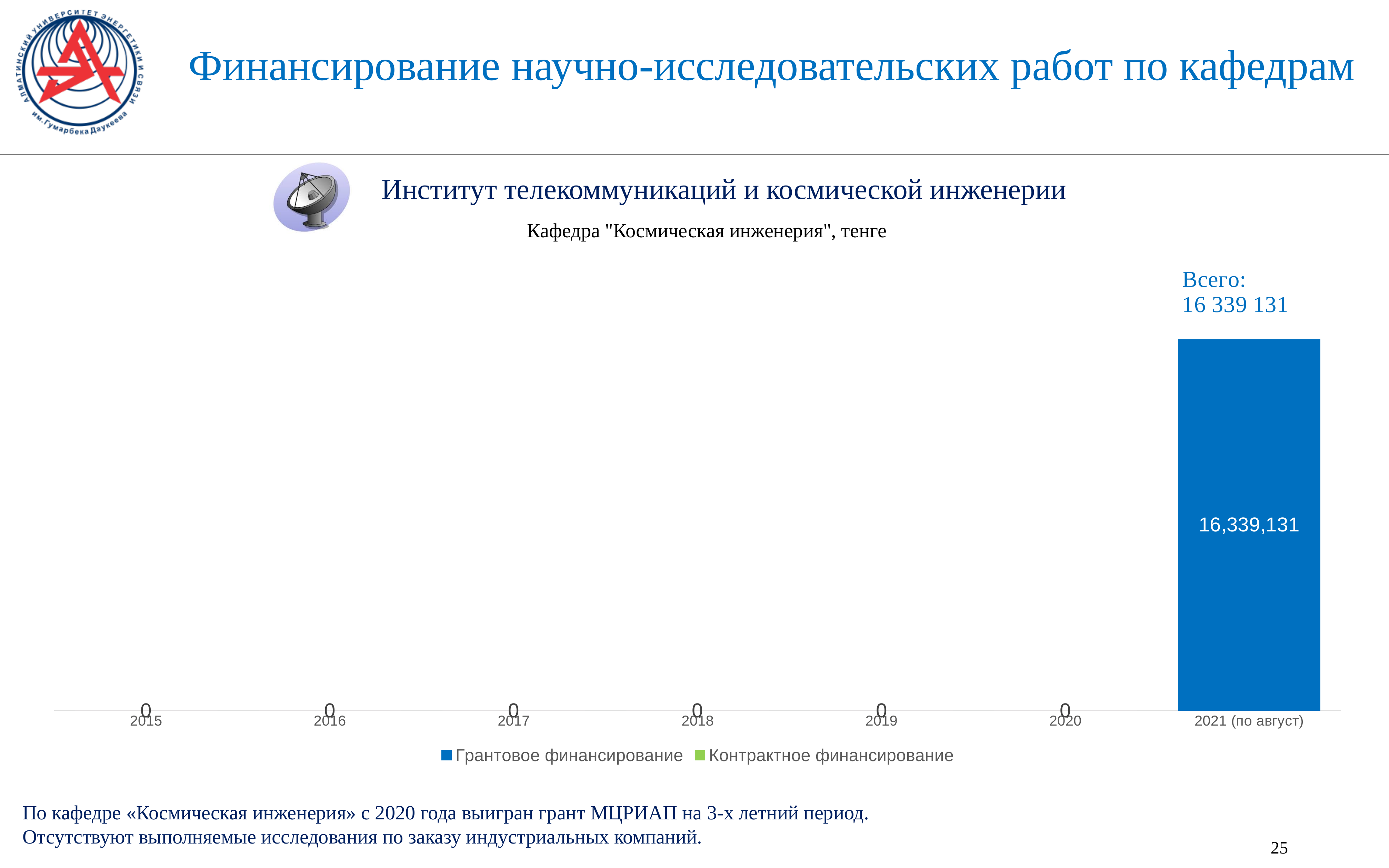
Which year has the highest value on the chart? 2021 (по августу) What is the title of the chart? Кафедра "Космическая инженерия", тенге What is the value shown for 2015? 0 Do the values rise or fall from 2020 to 2021 (по августу)? rise How many series does the legend list? 2 What kind of chart is shown on the slide? bar chart What is the value shown for 2020? 0 What is the value of grant funding (Грантовое финансирование) for 2021 (по августу)? 16,339,131 How many year categories are shown on the x axis? 7 What total (Всего) is printed above the chart? 16 339 131 What is the difference between the value for 2021 (по августу) and the value for 2018? 16,339,131 Is the value for 2021 (по августу) larger or smaller than the value for 2019? larger